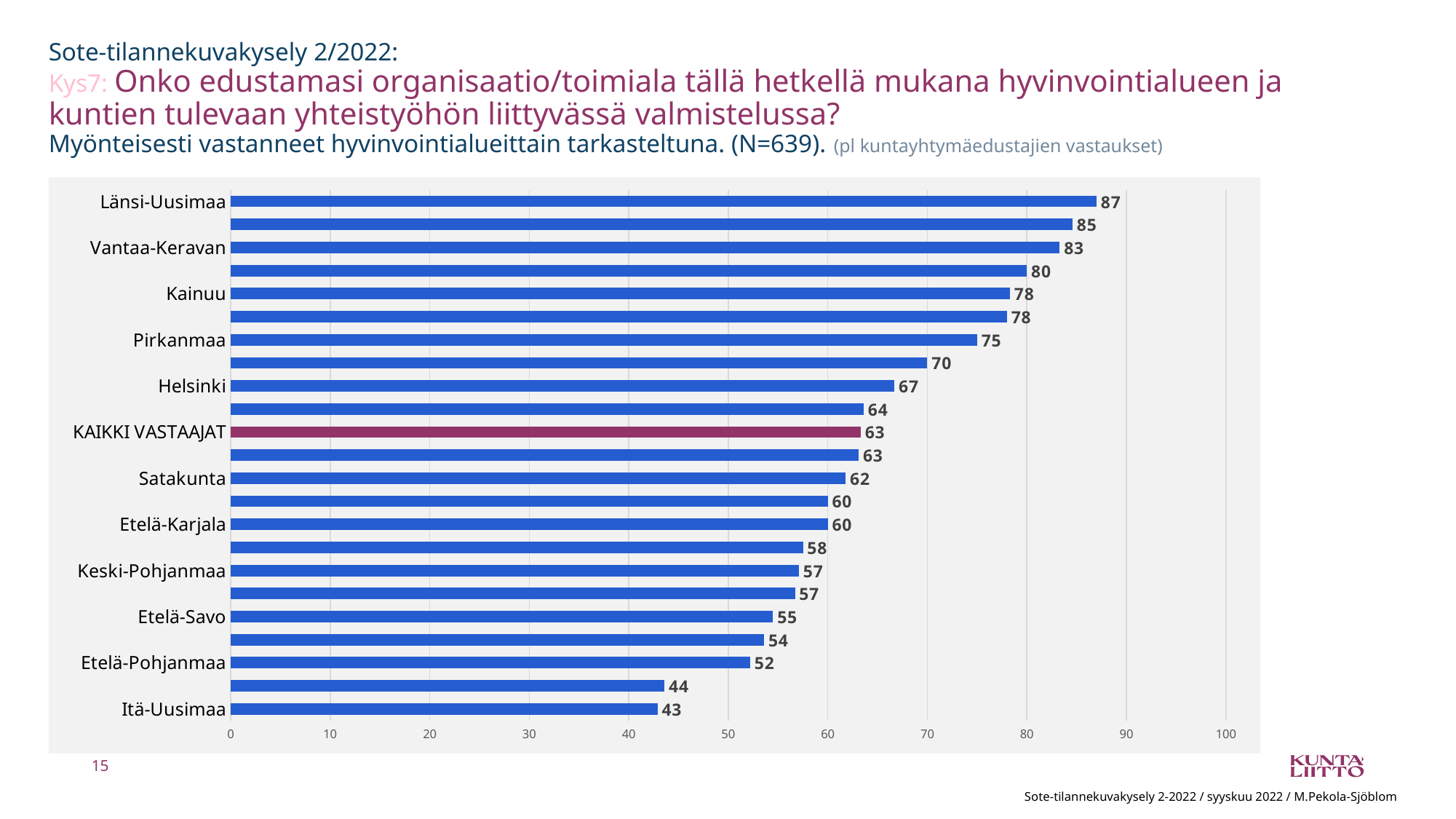
What value is shown for Länsi-Uusimaa? 87 Which labelled category has the lowest value? Itä-Uusimaa Which labelled category has the highest value? Länsi-Uusimaa What is the difference between the values for Kainuu and Satakunta? 16 Which has a larger value, Pirkanmaa or Etelä-Savo? Pirkanmaa How many bars are plotted in the chart? 23 What is the difference between the values for Länsi-Uusimaa and Itä-Uusimaa? 44 Which bar is drawn in a different colour from the others? KAIKKI VASTAAJAT What kind of chart is shown on the slide? Bar chart What value is shown for KAIKKI VASTAAJAT? 63 What value is shown for Etelä-Pohjanmaa? 52 What value is shown for Helsinki? 67